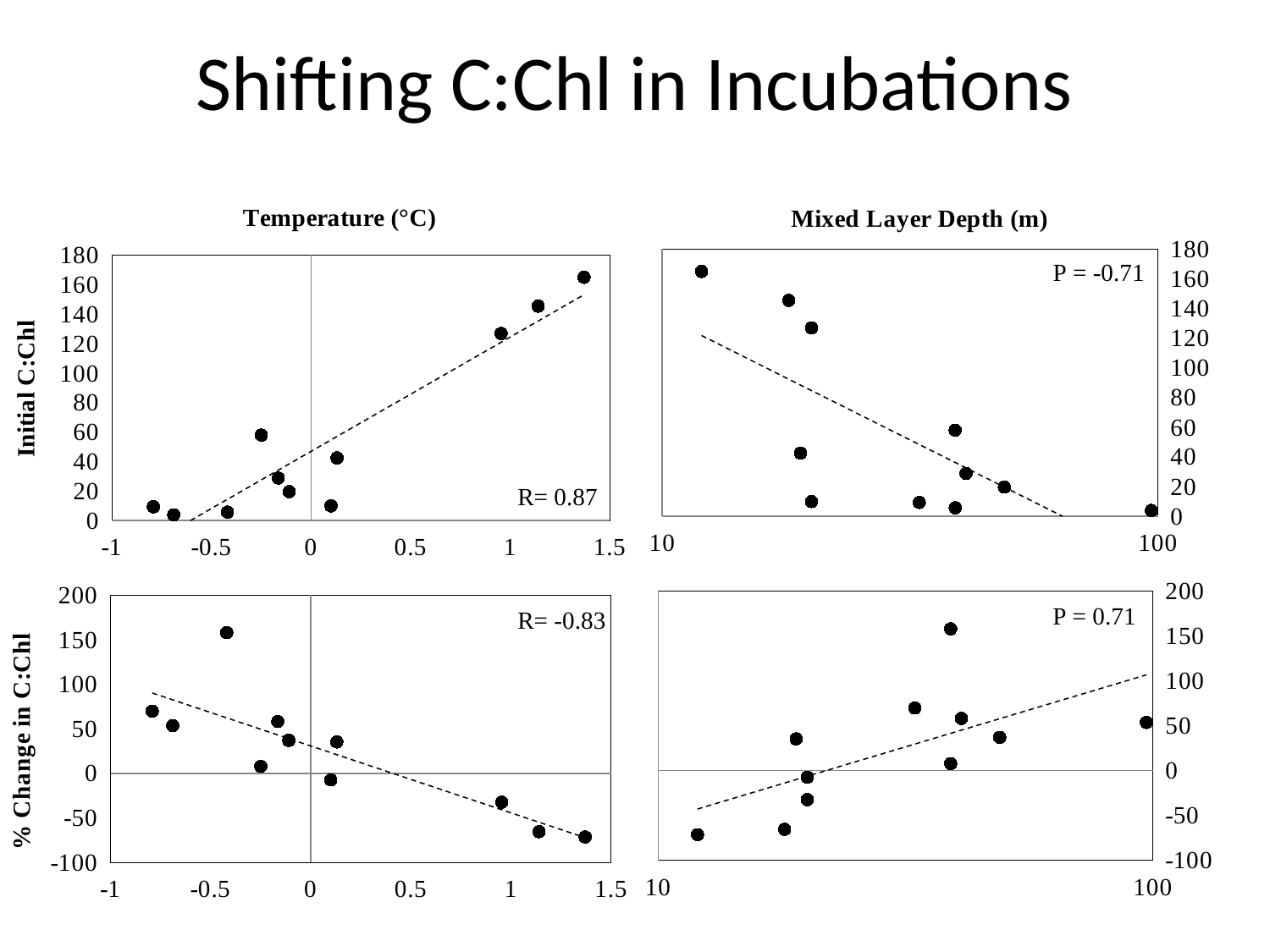
In the top-right chart (Mixed Layer Depth vs Initial C:Chl), is the Initial C:Chl value of the point at about 100 m greater or less than 20? less In the bottom-left chart (Temperature vs % Change in C:Chl), is the % Change value of the highest point greater or less than 100? greater What value is printed in the top-right corner of the bottom-right chart (Mixed Layer Depth vs % Change in C:Chl)? P = 0.71 In the top-right chart (Mixed Layer Depth vs Initial C:Chl), do the values rise or fall as mixed layer depth increases along the x axis? fall In the bottom-left chart (Temperature vs % Change in C:Chl), is the % Change value of the lowest point greater or less than -50? less In the bottom-right chart (Mixed Layer Depth vs % Change in C:Chl), does the dashed trend line rise or fall along the x axis? rise In the bottom-left chart (Temperature vs % Change in C:Chl), do the values rise or fall as temperature increases along the x axis? fall What kind of chart is the top-left chart under the Temperature (°C) heading? scatter plot What correlation coefficient is printed on the top-left chart (Temperature vs Initial C:Chl)? R= 0.87 How many data points are plotted in the top-left chart (Temperature vs Initial C:Chl)? 11